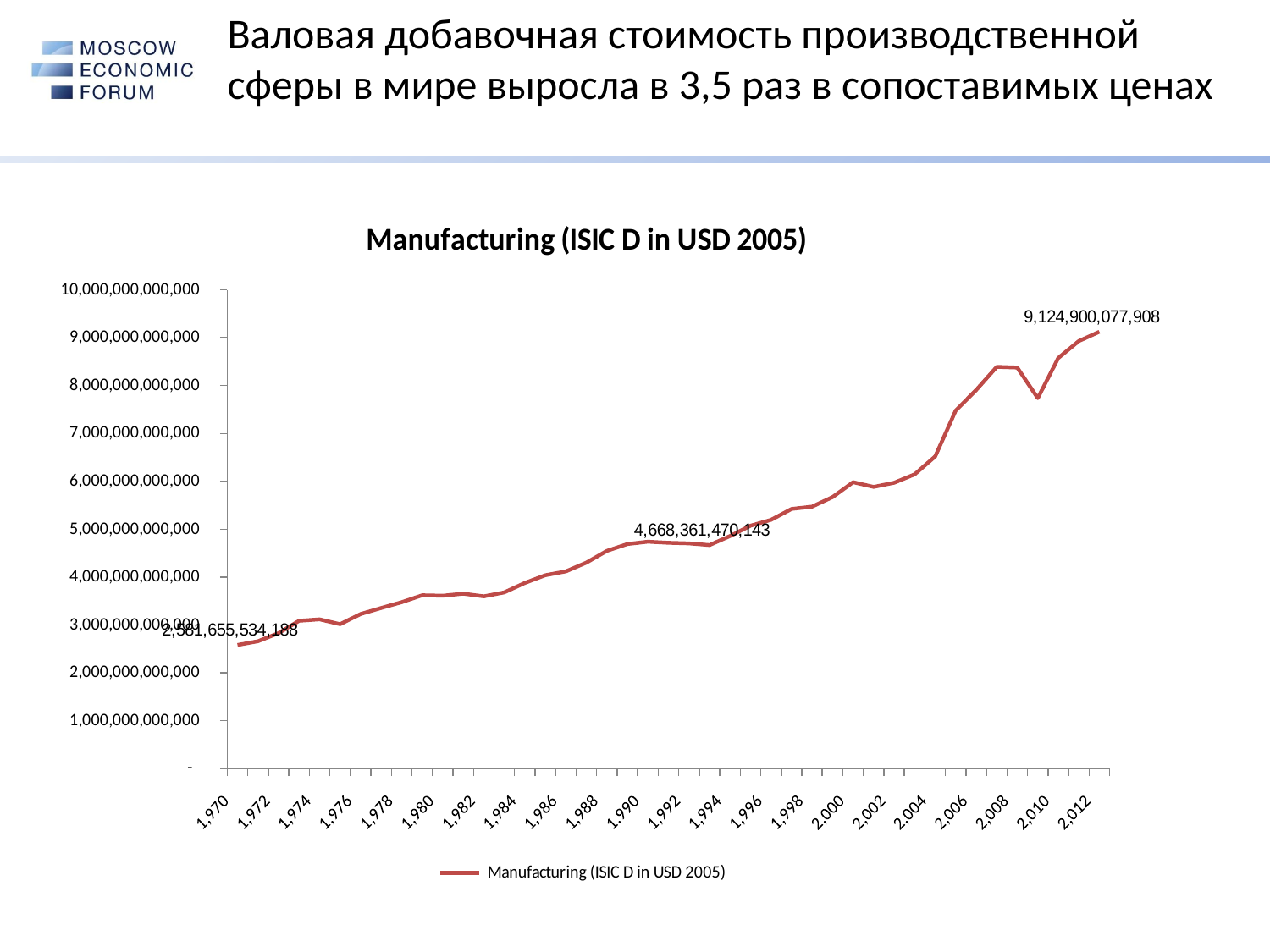
Is the value for 1990 greater or less than 4,000,000,000,000? greater Is the value for 2009 greater or less than 8,000,000,000,000? less Do the values generally rise or fall from 1970 to 2012? rise What is the data label shown for the last point (2012) on the line? 9,124,900,077,908 In which year does the line have its lowest value? 1970 What kind of chart is shown on the slide? line chart What is the title of the chart? Manufacturing (ISIC D in USD 2005) Is the value for 2006 greater or less than 7,000,000,000,000? greater Which year has the larger value, 2008 or 2009? 2008 In which year does the line reach its highest value? 2012 How many series does the legend list? 1